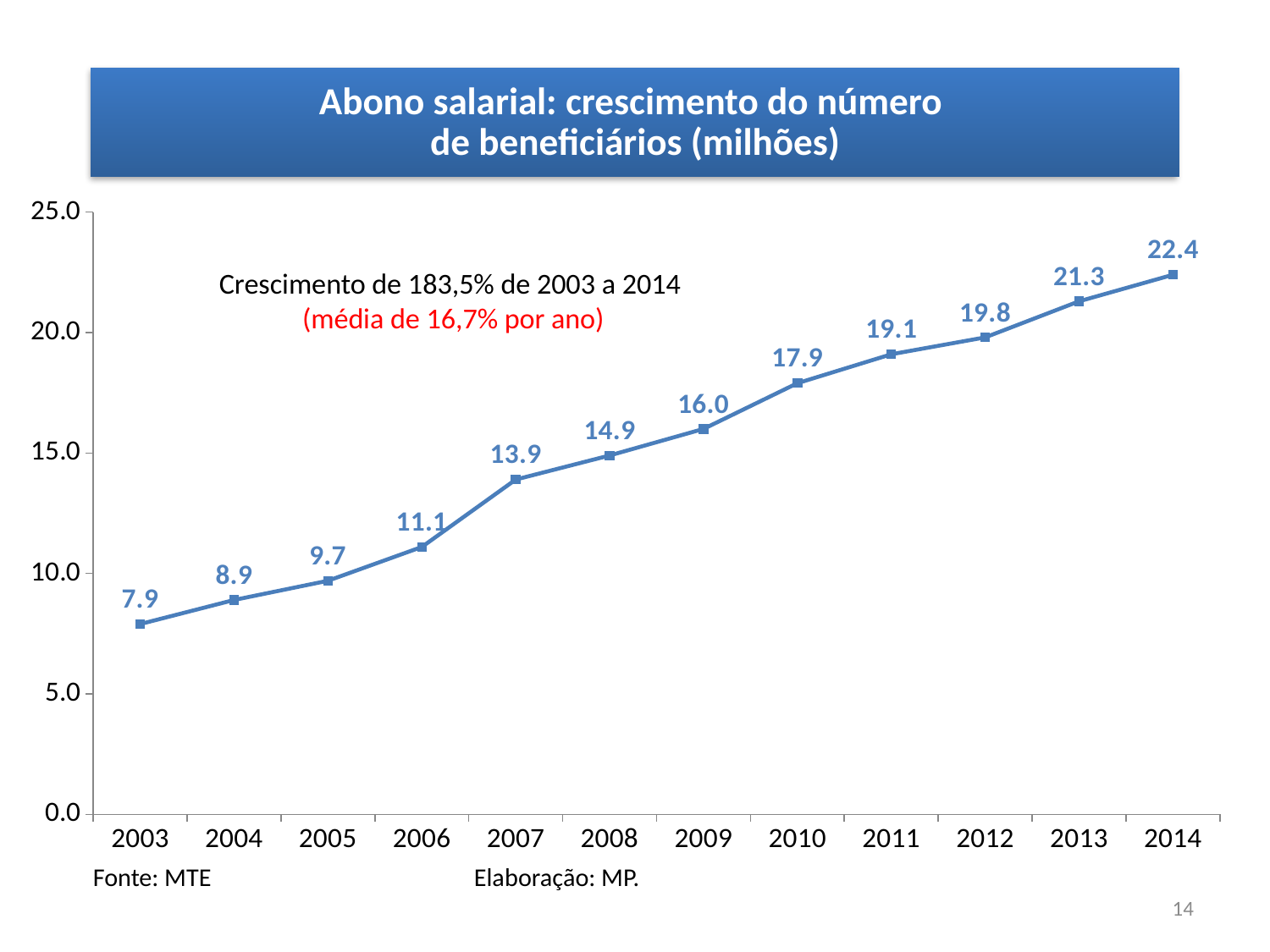
What is the value for 2010? 17.9 What is the difference between the values for 2007 and 2006? 2.8 Do the values rise or fall from 2003 to 2014? rise Which year has the highest value? 2014 What is the value for 2003? 7.9 Which year has the lowest value? 2003 Is the value for 2009 greater or less than 15.0? greater What kind of chart is shown? line chart What is the difference between the values for 2014 and 2003? 14.5 How many years are plotted on the chart? 12 Which is larger, the value for 2008 or the value for 2011? 2011 What is the value for 2014? 22.4